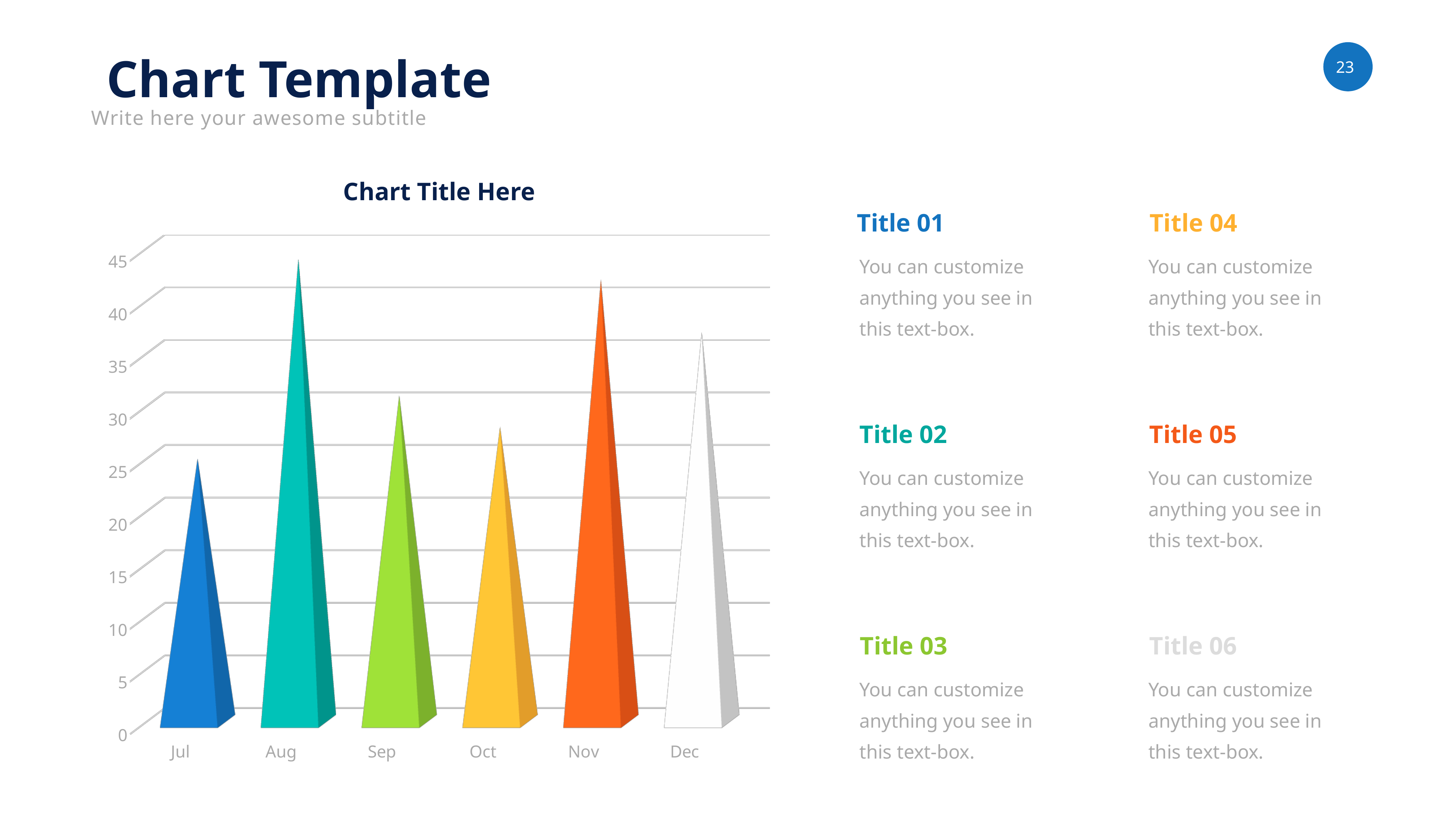
What kind of chart is shown on the slide? bar chart Which month has the highest value in the chart? Aug Which month has the lowest value in the chart? Jul Is the value for Aug greater or less than 40? greater What is the title of the chart? Chart Title Here Is the value for Dec greater or less than 35? greater Is the value for Nov greater or less than 40? greater What is the highest value labelled on the y axis of the chart? 45 Which is larger, the value for Sep or the value for Oct? Sep How many categories are shown on the x axis of the chart? 6 Which is larger, the value for Dec or the value for Jul? Dec